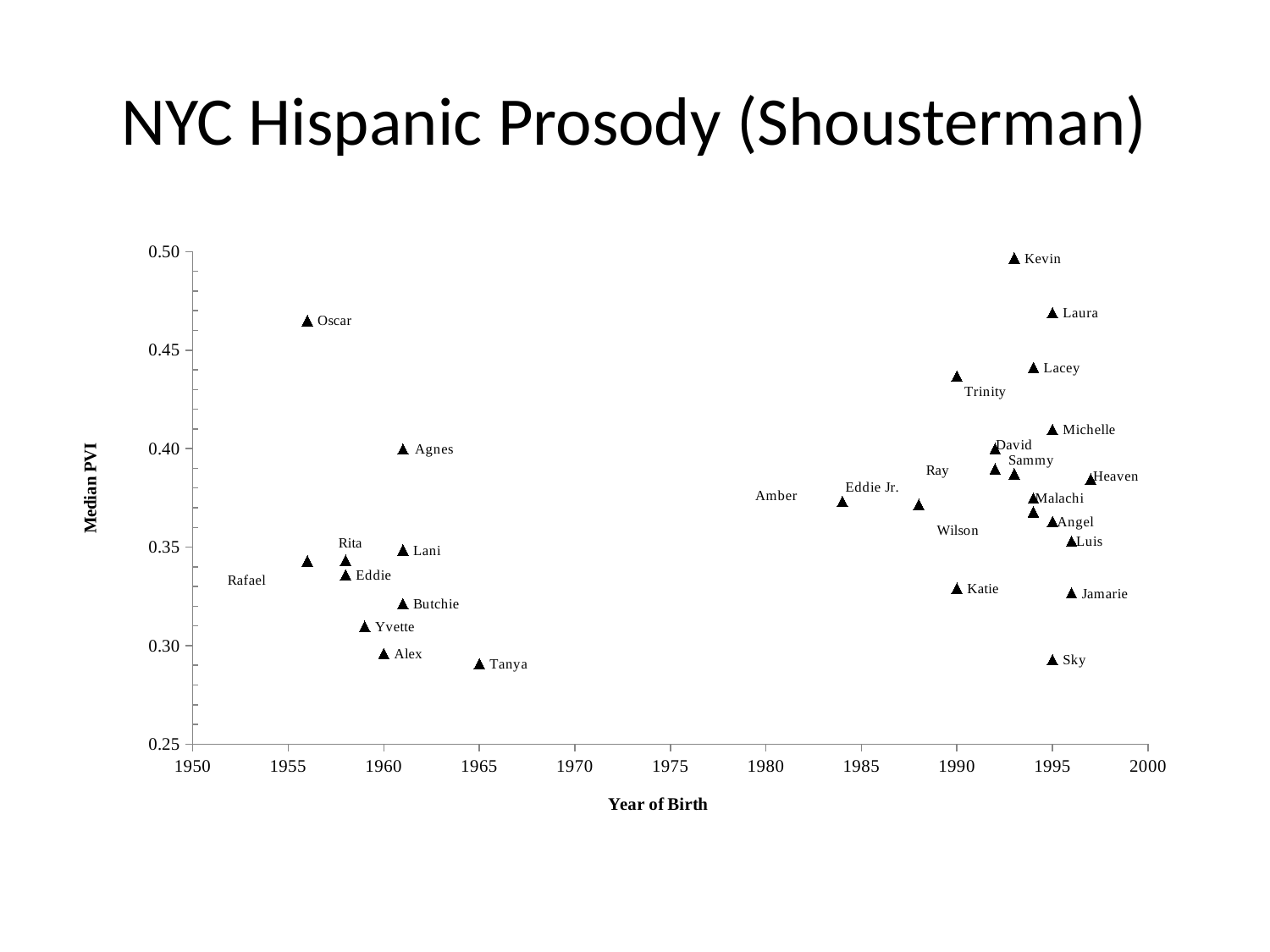
Is the Median PVI value for Trinity greater or less than 0.40? greater Is the Median PVI value for Laura greater or less than 0.45? greater Who has the higher Median PVI, Lacey or Sky? Lacey What kind of chart is shown on the slide? Scatter plot Is the Median PVI value for Alex greater or less than 0.30? less What is the label of the y axis? Median PVI Which person has the highest Median PVI on the chart? Kevin Who has the higher Median PVI, Oscar or Agnes? Oscar What is the label of the x axis? Year of Birth